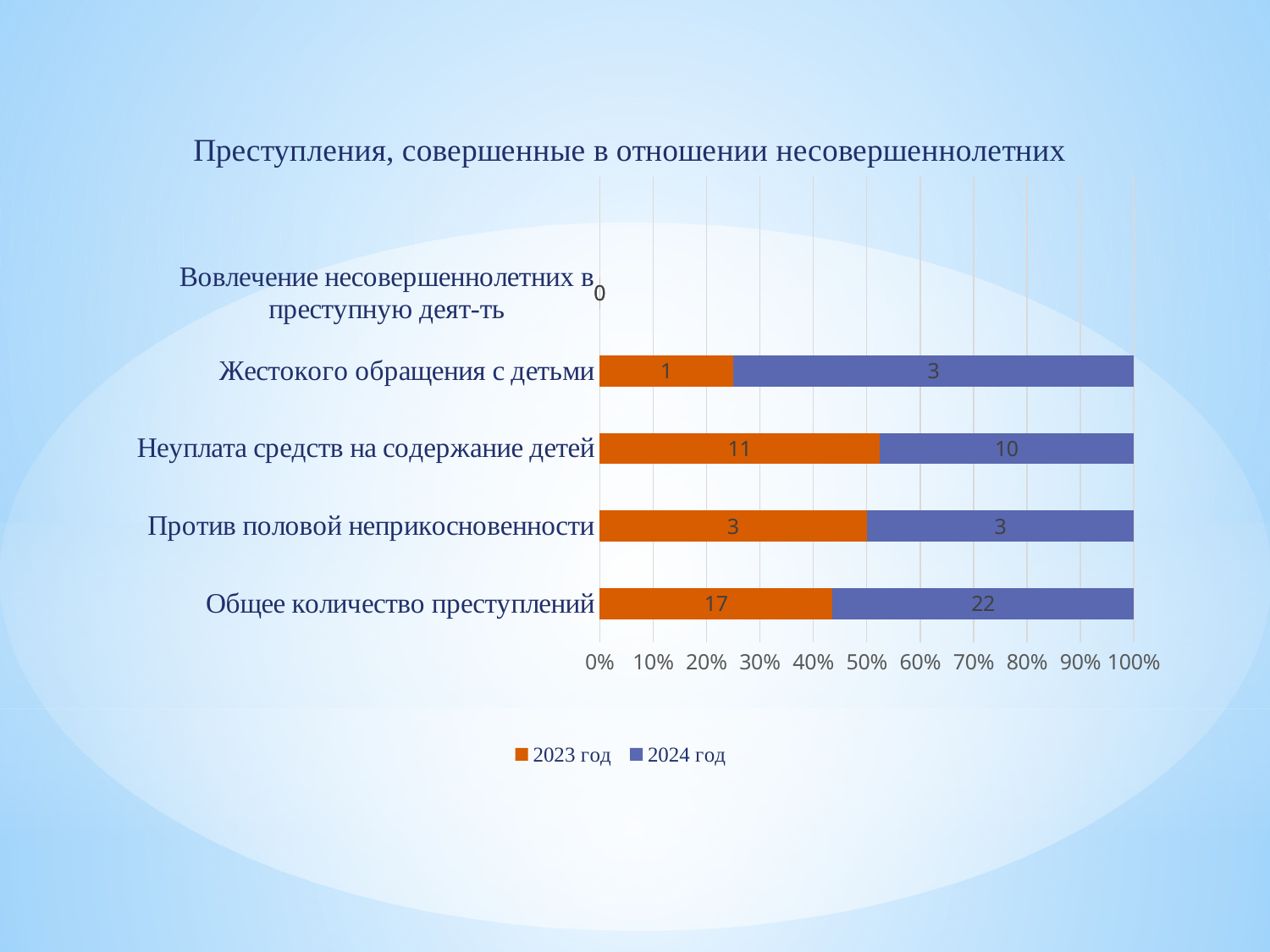
How many series does the legend list? 2 What is the title of the chart? Преступления, совершенные в отношении несовершеннолетних What is the value for 2023 год for Общее количество преступлений? 17 What is the total of the two values in the bar for Жестокого обращения с детьми? 4 What kind of chart is shown on the slide? Stacked bar chart Which category has the highest value for 2024 год? Общее количество преступлений What is the value for 2023 год for Против половой неприкосновенности? 3 What is the value for 2024 год for Жестокого обращения с детьми? 3 How many categories are shown on the chart? 5 Which is larger for Неуплата средств на содержание детей: the 2023 год value or the 2024 год value? 2023 год What is the difference between the 2024 год and 2023 год values for Общее количество преступлений? 5 What is the value for 2024 год for Неуплата средств на содержание детей? 10